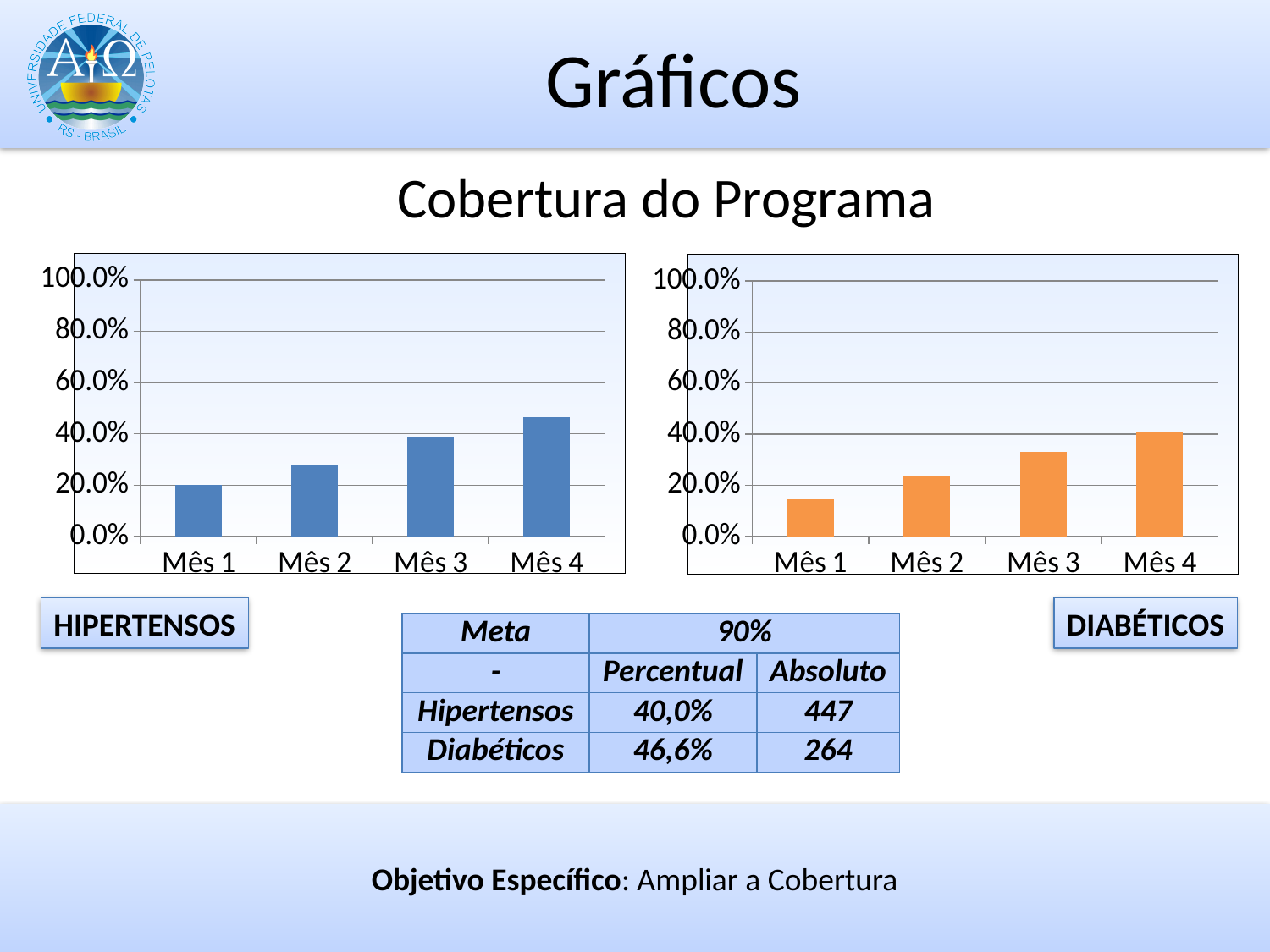
In the HIPERTENSOS chart on the left, which month has the highest value? Mês 4 What colour are the bars in the DIABÉTICOS chart on the right? orange What kind of chart is the HIPERTENSOS chart on the left? bar chart In the HIPERTENSOS chart on the left, do the values rise or fall from Mês 1 to Mês 4? rise How many months are shown on the x axis of the DIABÉTICOS chart on the right? 4 In the DIABÉTICOS chart on the right, which is larger, the value for Mês 2 or the value for Mês 3? Mês 3 In the DIABÉTICOS chart on the right, is the value for Mês 1 greater or less than 20.0%? less In the DIABÉTICOS chart on the right, is the value for Mês 3 greater or less than 40.0%? less In the HIPERTENSOS chart on the left, which month has the lowest value? Mês 1 In the DIABÉTICOS chart on the right, which month has the highest value? Mês 4 In the HIPERTENSOS chart on the left, is the value for Mês 4 greater or less than 40.0%? greater